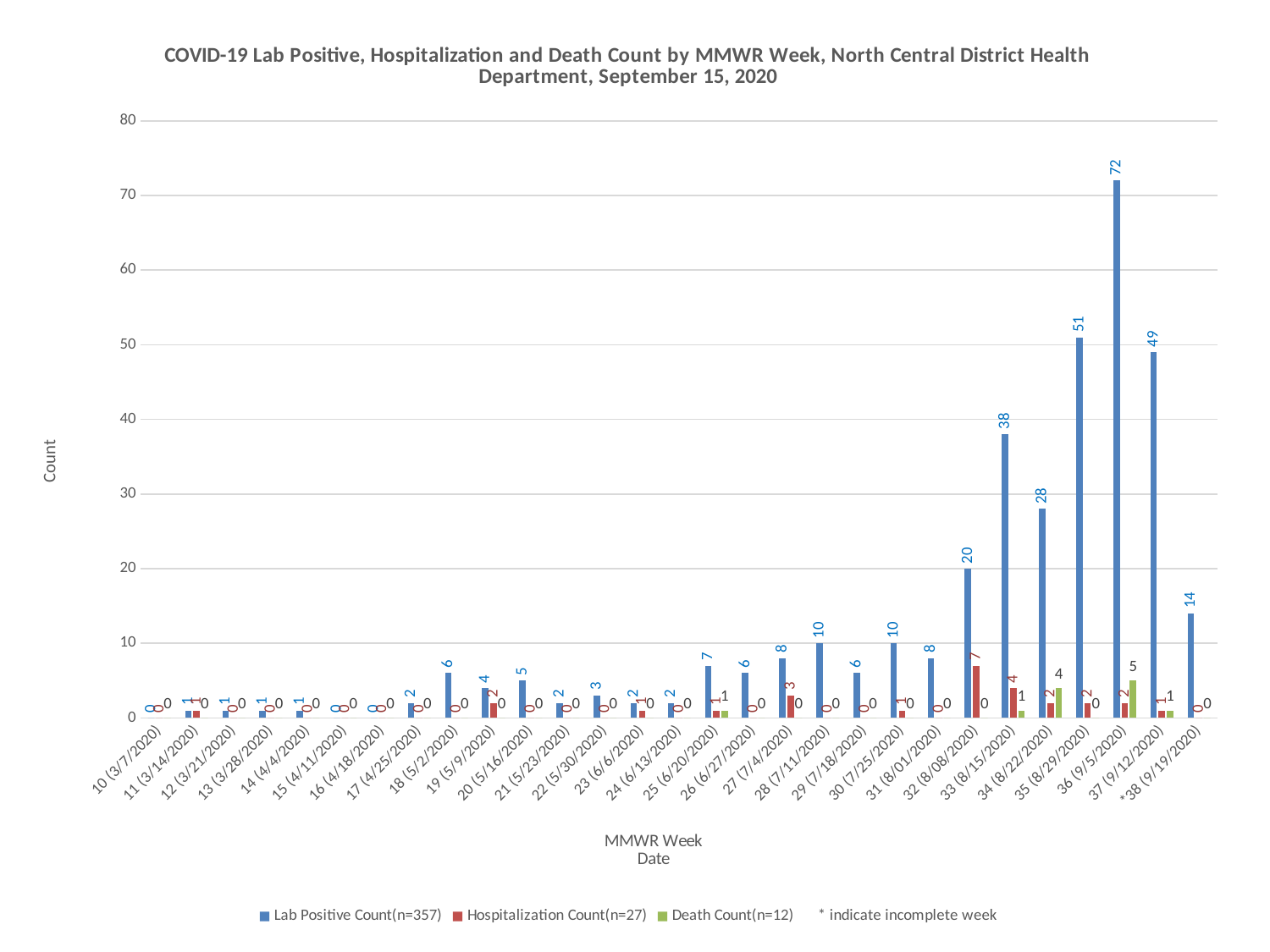
What is the Hospitalization Count for MMWR week 32 (8/08/2020)? 7 Which MMWR week has the highest Lab Positive Count? 36 (9/5/2020) According to the legend, what does an asterisk (*) on a week label indicate? Incomplete week Is the Lab Positive Count for week 35 (8/29/2020) greater or less than 40? greater What is the difference between the Lab Positive Count for week 36 (9/5/2020) and week 35 (8/29/2020)? 21 Which MMWR week has the highest Death Count? 36 (9/5/2020) What is the Death Count for MMWR week 34 (8/22/2020)? 4 How many series does the legend list? 3 How many MMWR weeks are shown on the x axis? 29 Which is larger, the Lab Positive Count for week 33 (8/15/2020) or for week 37 (9/12/2020)? Week 37 (9/12/2020) What is the Lab Positive Count for MMWR week 36 (9/5/2020)? 72 What kind of chart is shown on the slide? Bar chart